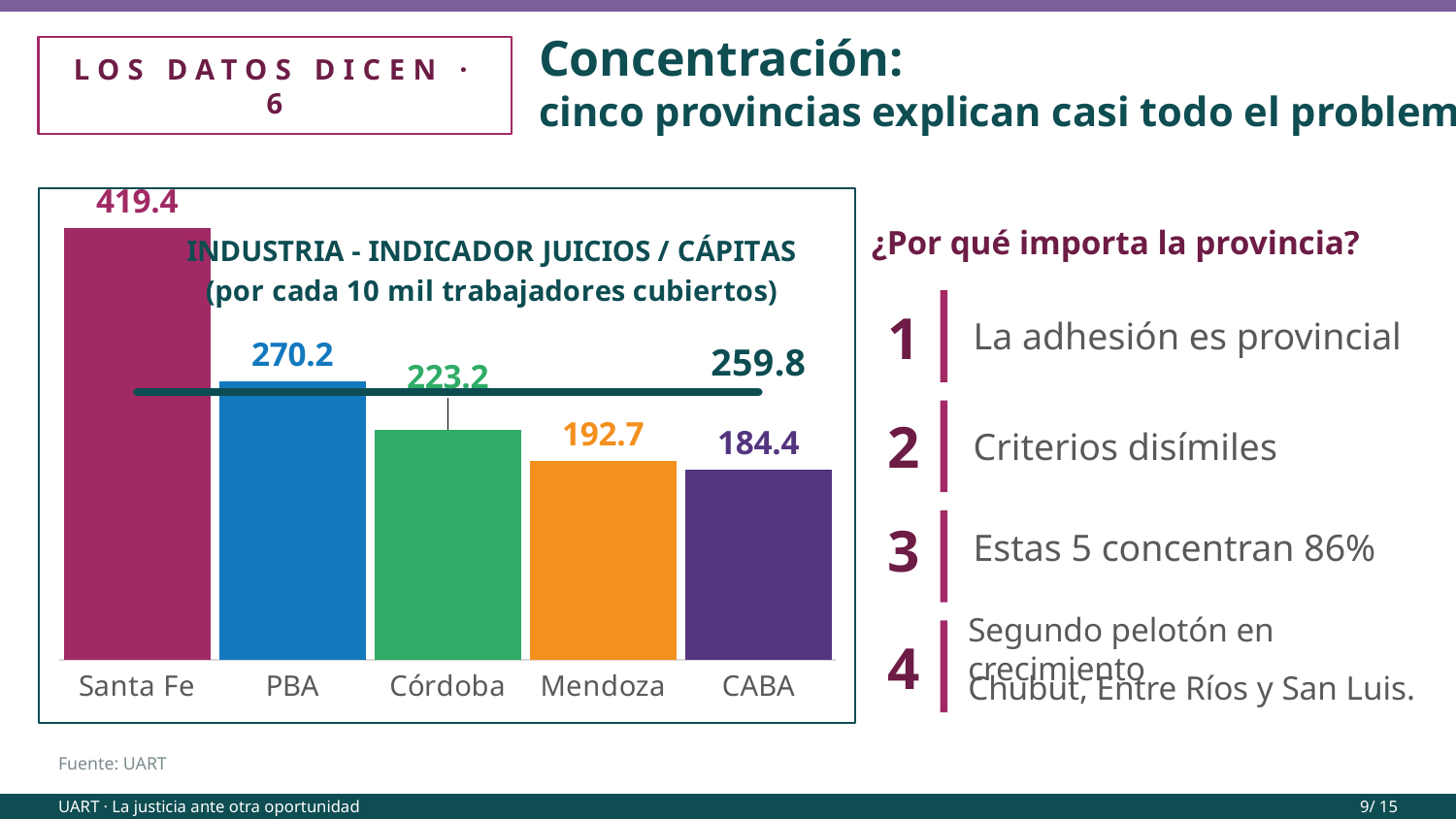
What is the value for CABA? 184.4 Which has a larger value, Córdoba or Mendoza? Córdoba Which province has the highest value? Santa Fe What is the value for Santa Fe? 419.4 What is the value for Mendoza? 192.7 What is the value for PBA? 270.2 What kind of chart is shown on the slide? Bar chart What is the difference between the values for Santa Fe and PBA? 149.2 Which province has the lowest value? CABA How many provinces are shown in the chart? 5 What value is labelled on the horizontal reference line across the chart? 259.8 What is the value for Córdoba? 223.2